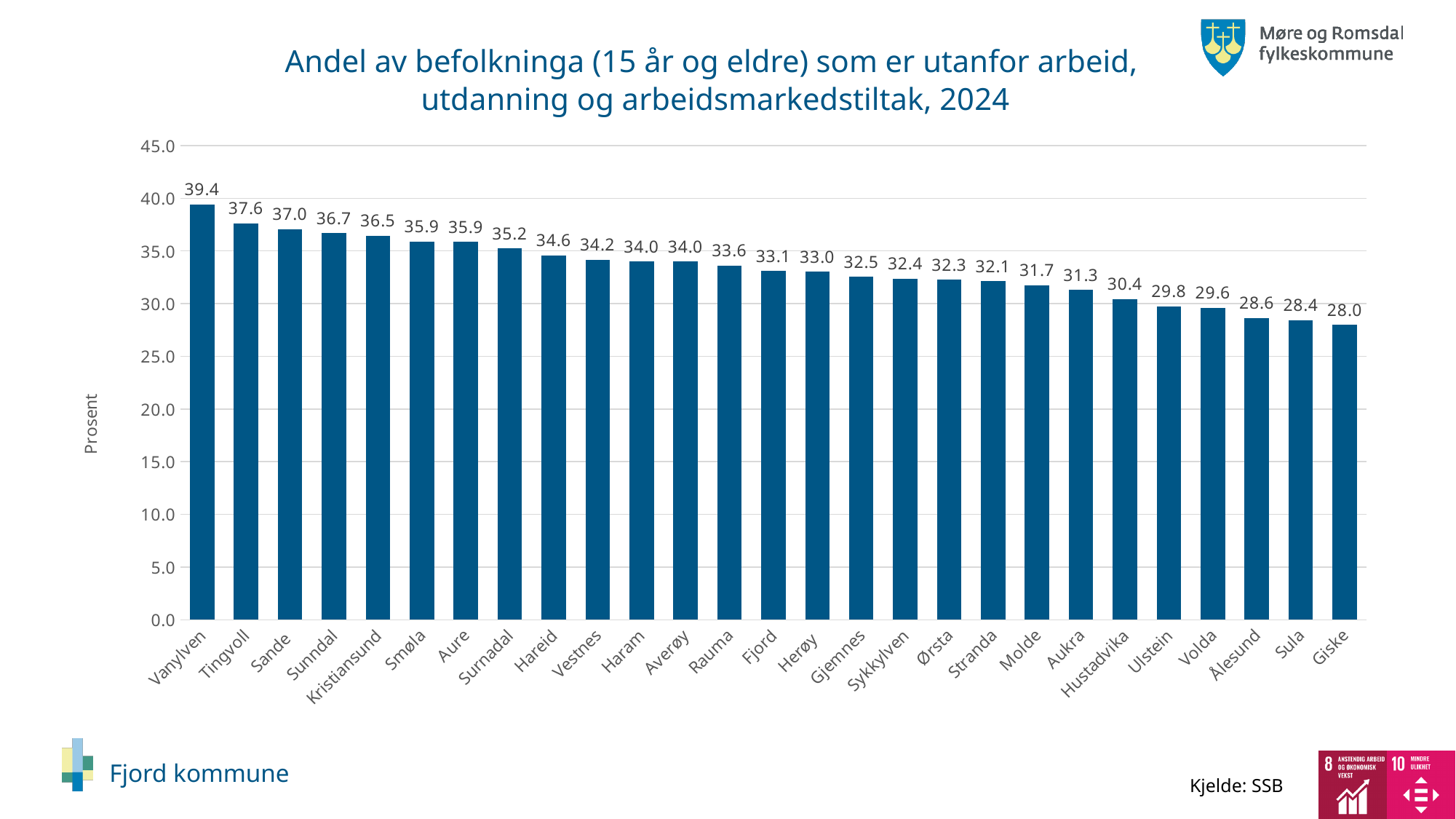
What is the difference between the values for Tingvoll and Ålesund? 9.0 What is the label on the vertical axis? Prosent How many municipalities are shown on the chart? 27 What is the value for Fjord? 33.1 Is the value for Hustadvika greater or less than 35.0? less What is the difference between the values for Vanylven and Giske? 11.4 What kind of chart is this? bar chart What is the value for Molde? 31.7 What is the value for Kristiansund? 36.5 Which municipality has the highest value? Vanylven Which has a larger value, Sunndal or Volda? Sunndal Which municipality has the lowest value? Giske